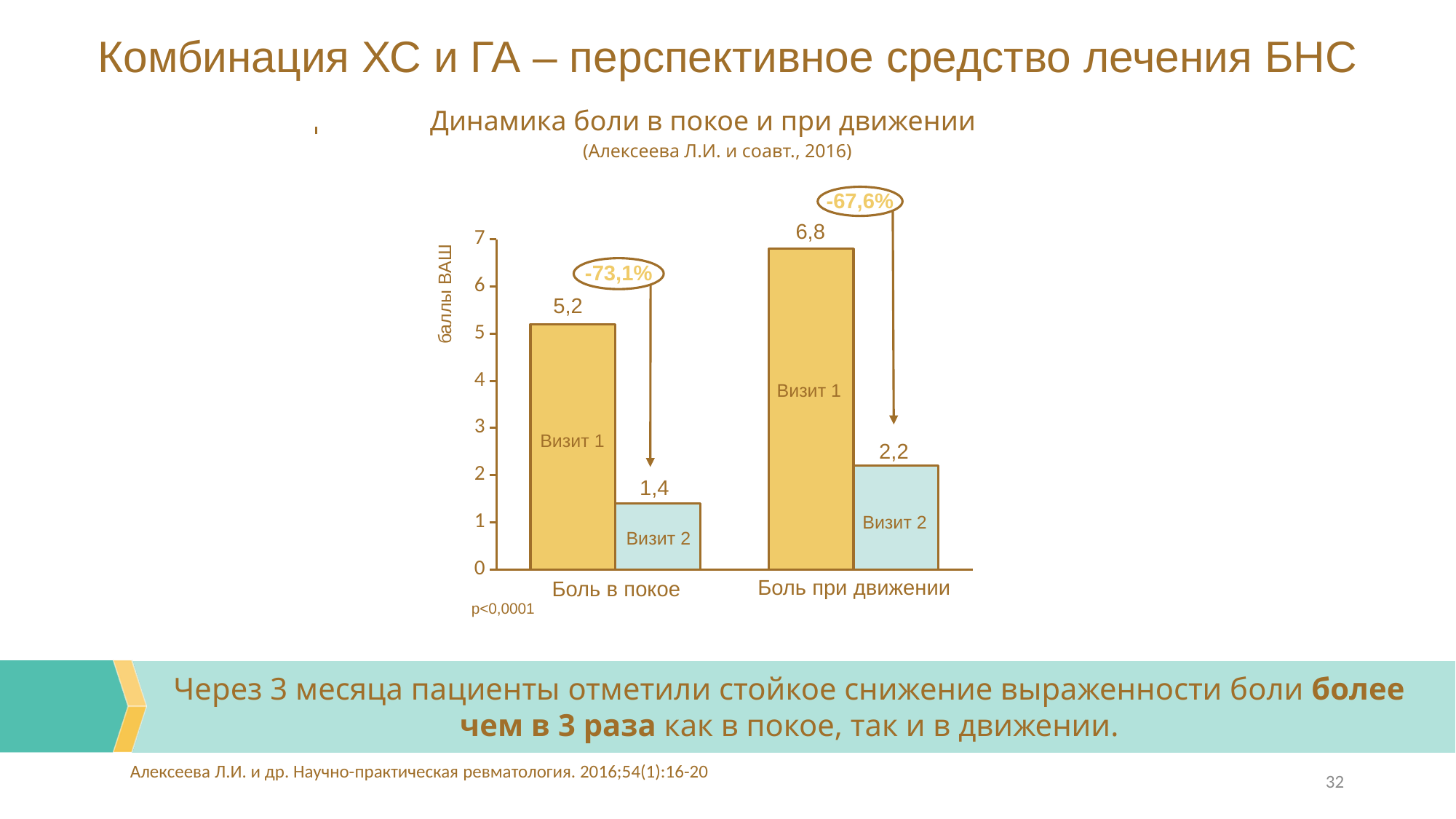
What kind of chart is shown on the slide? Bar chart Which bar has the lowest value on the chart? Визит 2, Боль в покое What is the value for Визит 2 in the Боль в покое category? 1,4 What is the value for Визит 1 in the Боль в покое category? 5,2 Which bar has the highest value on the chart? Визит 1, Боль при движении What is the difference between Визит 1 and Визит 2 for Боль при движении? 4,6 What percentage change is shown in the oval above the Боль при движении bars? -67,6% What is the difference between Визит 1 and Визит 2 for Боль в покое? 3,8 What is the value for Визит 2 in the Боль при движении category? 2,2 How many categories are shown on the x axis? 2 Which is larger: Визит 1 for Боль в покое or Визит 2 for Боль при движении? Визит 1 for Боль в покое What is the y-axis label of the chart? баллы ВАШ